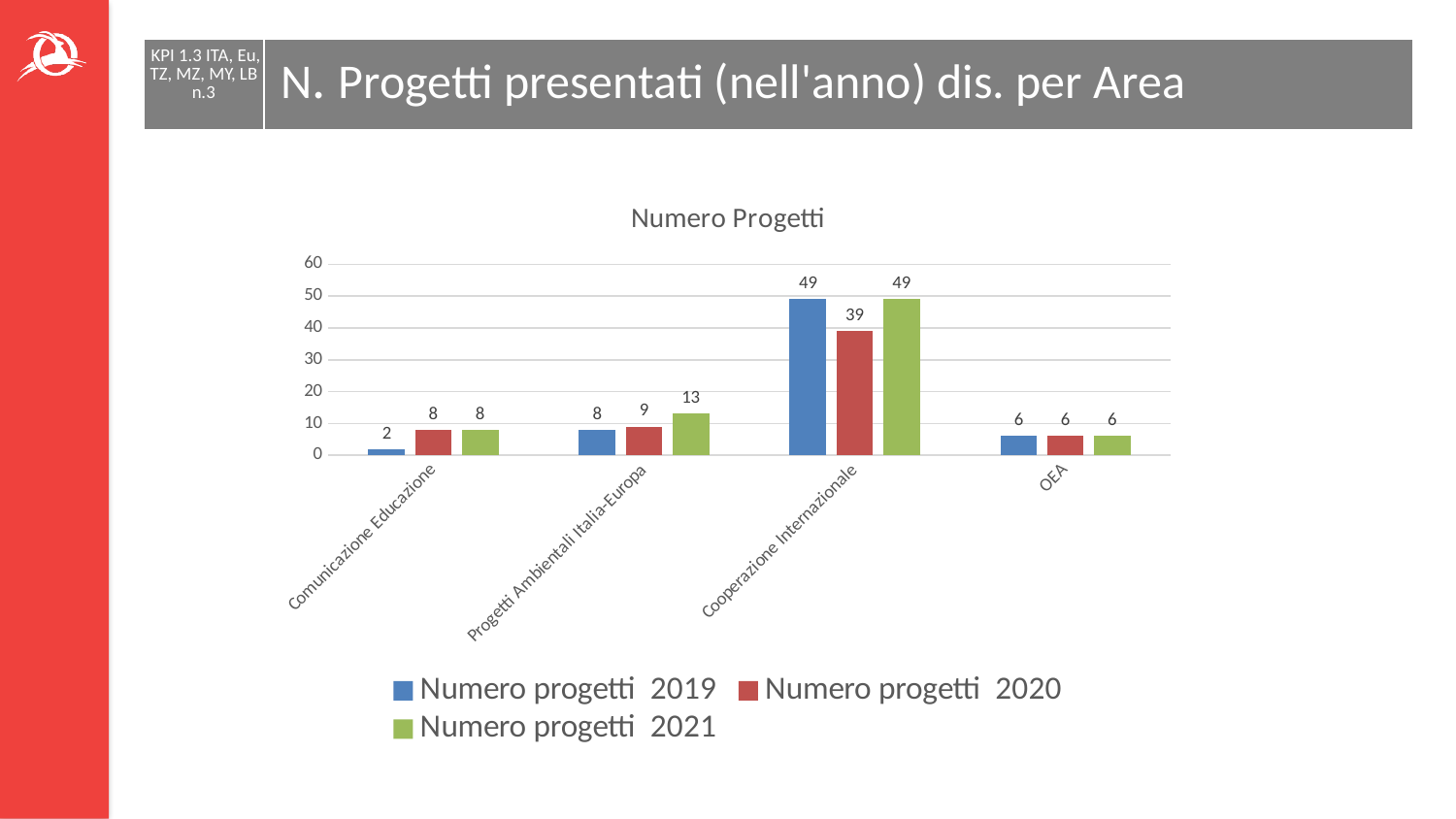
What is the value for Numero progetti 2021 in the Progetti Ambientali Italia-Europa category? 13 Which is larger for Progetti Ambientali Italia-Europa: Numero progetti 2020 or Numero progetti 2021? Numero progetti 2021 Which category has the highest value for Numero progetti 2019? Cooperazione Internazionale What is the title of the chart? Numero Progetti Is the value for Numero progetti 2021 in Cooperazione Internazionale greater or less than 40? greater What is the difference between the Numero progetti 2019 and Numero progetti 2020 values for Cooperazione Internazionale? 10 How many categories are shown on the x axis? 4 What is the value for Numero progetti 2020 in the Cooperazione Internazionale category? 39 Which category has the lowest value for Numero progetti 2019? Comunicazione Educazione How many series does the legend list? 3 What is the value for Numero progetti 2019 in the Comunicazione Educazione category? 2 What kind of chart is shown on the slide? Bar chart